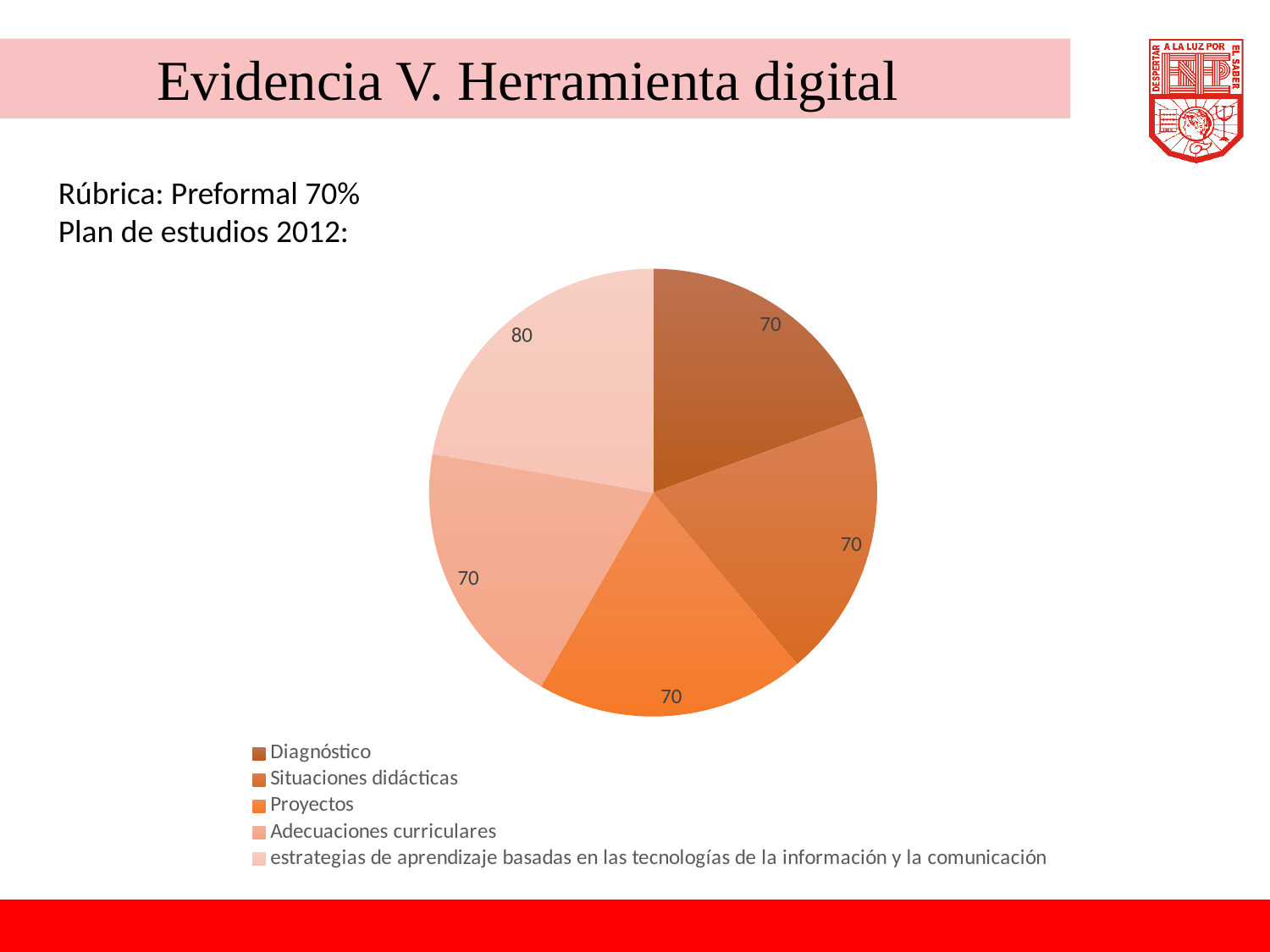
Which legend entry is listed first below the pie chart? Diagnóstico What is the value for Diagnóstico in the pie chart? 70 What is the value for 'estrategias de aprendizaje basadas en las tecnologías de la información y la comunicación' in the pie chart? 80 What is the value for Proyectos in the pie chart? 70 What kind of chart is shown on the slide? pie chart What is the total of all the values shown in the pie chart? 360 How many entries does the legend of the pie chart list? 5 What is the difference between the value for 'estrategias de aprendizaje basadas en las tecnologías de la información y la comunicación' and the value for Situaciones didácticas? 10 Which category has the largest slice in the pie chart? estrategias de aprendizaje basadas en las tecnologías de la información y la comunicación How many slices does the pie chart have? 5 What is the value for Adecuaciones curriculares in the pie chart? 70 Which is larger in the pie chart: the value for Diagnóstico or the value for 'estrategias de aprendizaje basadas en las tecnologías de la información y la comunicación'? estrategias de aprendizaje basadas en las tecnologías de la información y la comunicación